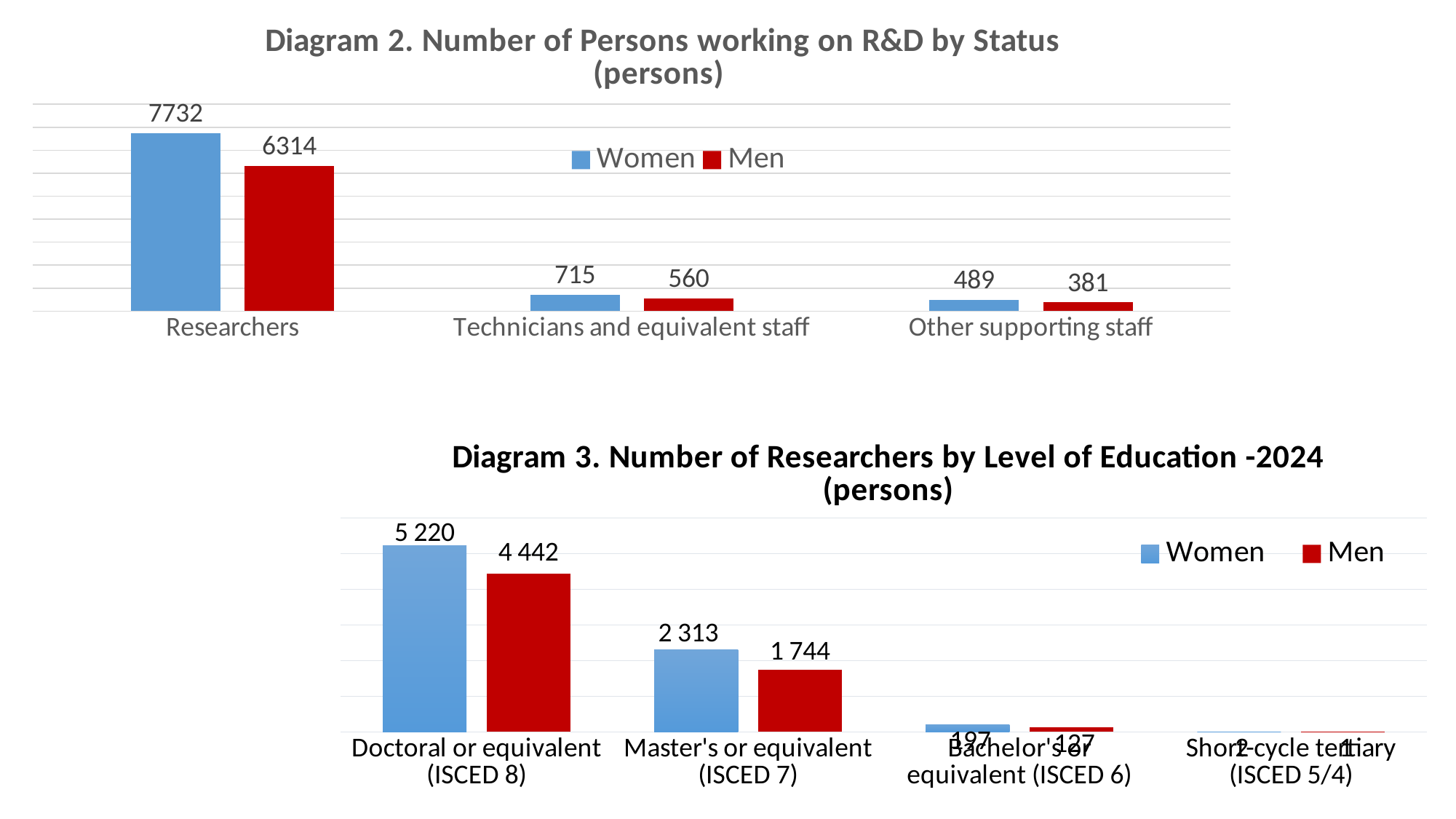
In Diagram 2, what kind of chart is shown? Bar chart In Diagram 2, how many women are researchers? 7732 In Diagram 3, how many women researchers have a doctoral or equivalent (ISCED 8) education? 5 220 In Diagram 2, what is the number of men among technicians and equivalent staff? 560 In Diagram 2, what is the difference between women and men researchers? 1418 In Diagram 2, which status category has the highest number of women? Researchers In Diagram 3, what is the difference between women and men at the master's or equivalent level? 569 In Diagram 3, what is the number of men with a master's or equivalent (ISCED 7) education? 1 744 In Diagram 2, what is the value for women in the Other supporting staff category? 489 In Diagram 3, how many series does the legend list? 2 In Diagram 3, which is larger: women or men at the doctoral or equivalent level? Women In Diagram 2, how many status categories are shown on the x axis? 3